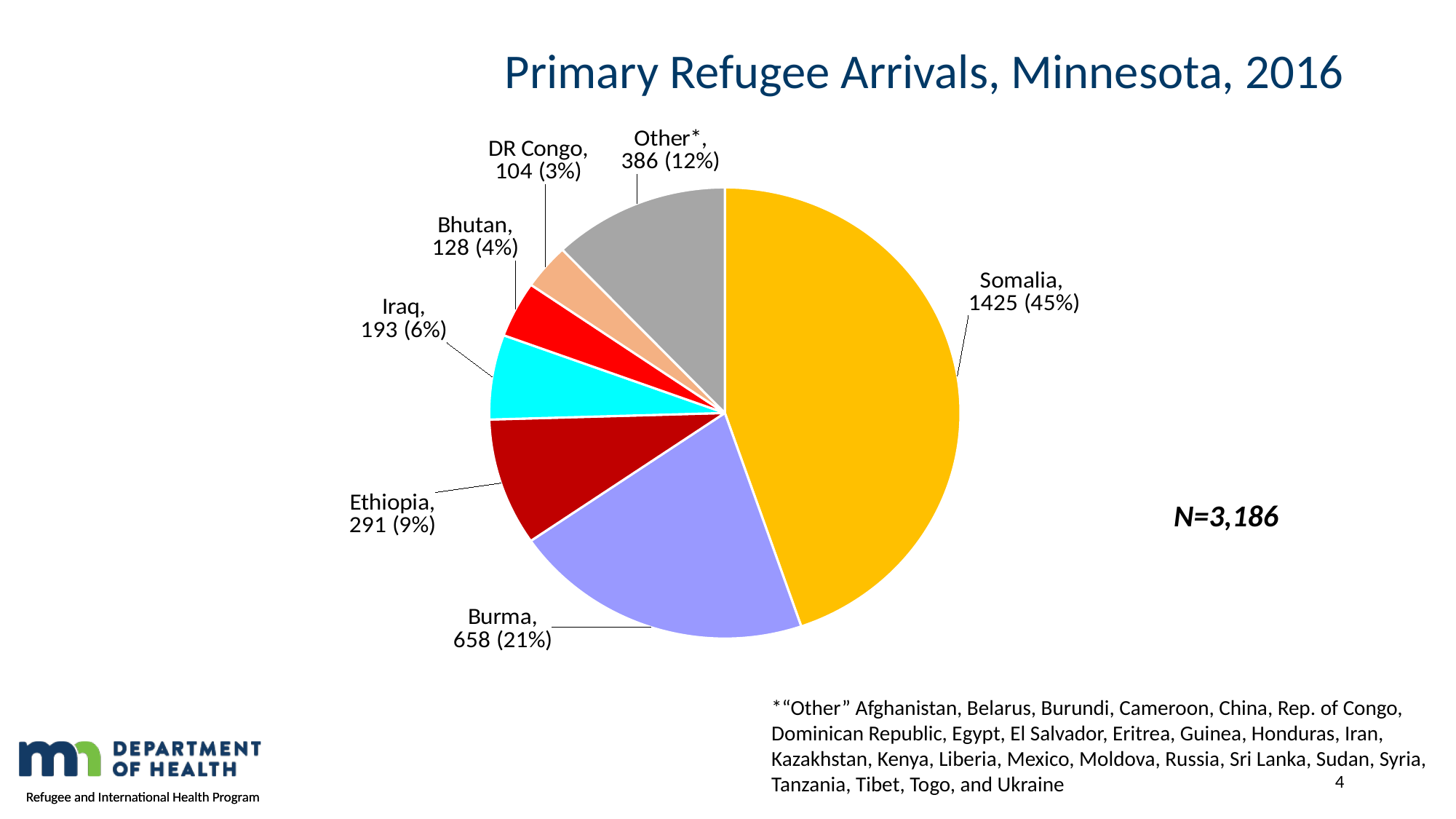
What total N is stated on the slide? N=3,186 How many primary refugee arrivals from Somalia are shown? 1425 What percentage share of arrivals does Burma represent? 21% What percentage share of arrivals does Ethiopia represent? 9% What is the title of the chart? Primary Refugee Arrivals, Minnesota, 2016 Which has more arrivals, Iraq or Bhutan? Iraq What is the number of arrivals in the Other category? 386 What is the difference between the number of arrivals from Burma and from Ethiopia? 367 What type of chart is shown on the slide? pie chart Which category has the smallest slice of the pie? DR Congo Which category has the largest slice of the pie? Somalia How many slices does the pie chart have? 7